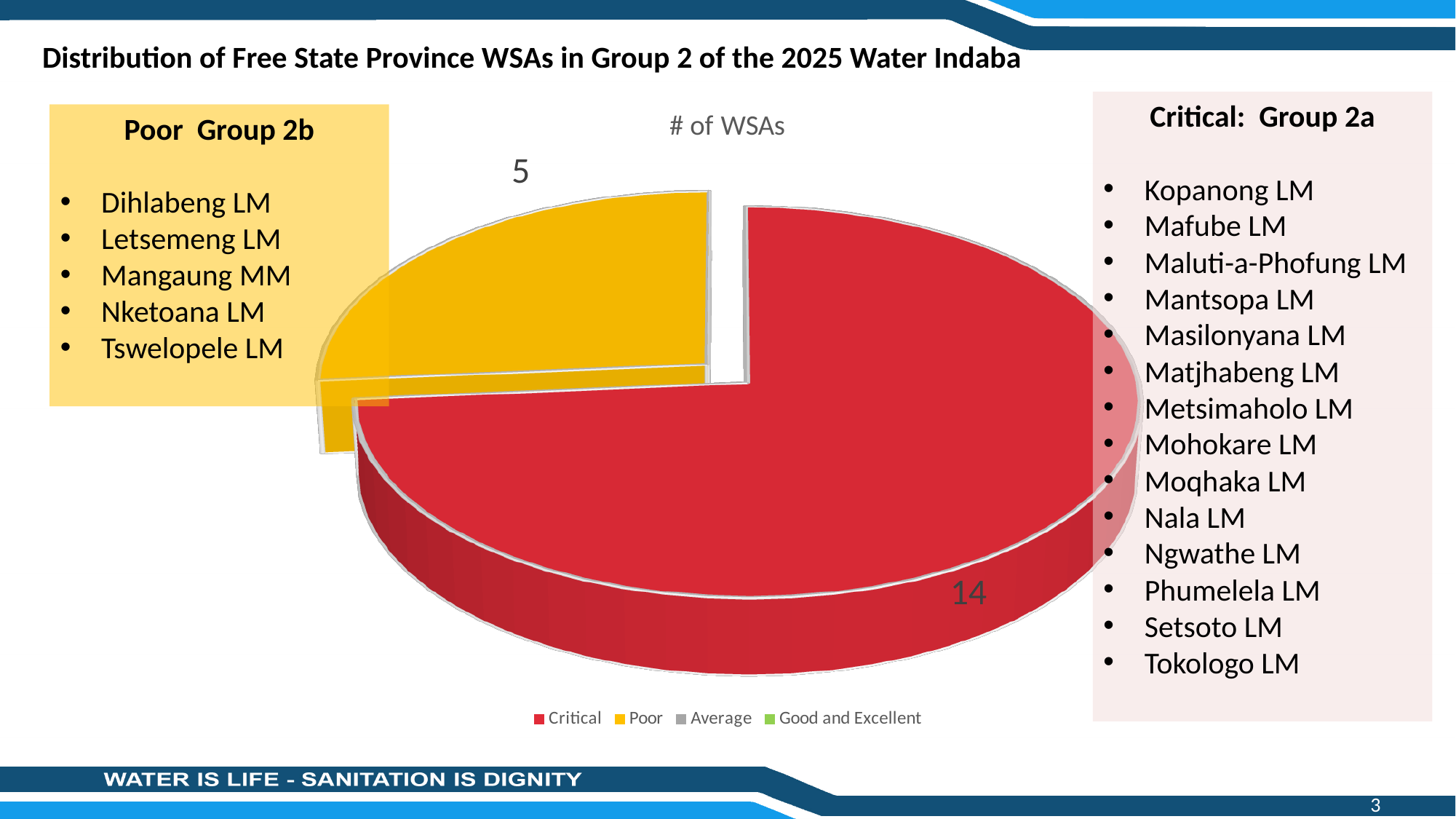
Which category has the largest slice of the pie? Critical Which of the labelled slices is the smallest? Poor Which is larger, the Critical slice or the Poor slice? Critical What colour represents the Poor category in the chart? Yellow How many WSAs are in the Poor category? 5 What type of chart is shown on the slide? Pie chart How many categories does the legend list? 4 How many WSAs are in the Critical category? 14 What is the total number of WSAs shown in the pie chart? 19 How many slices with data labels are visible in the pie chart? 2 What is the difference between the number of Critical WSAs and Poor WSAs? 9 What is the title of the chart? # of WSAs